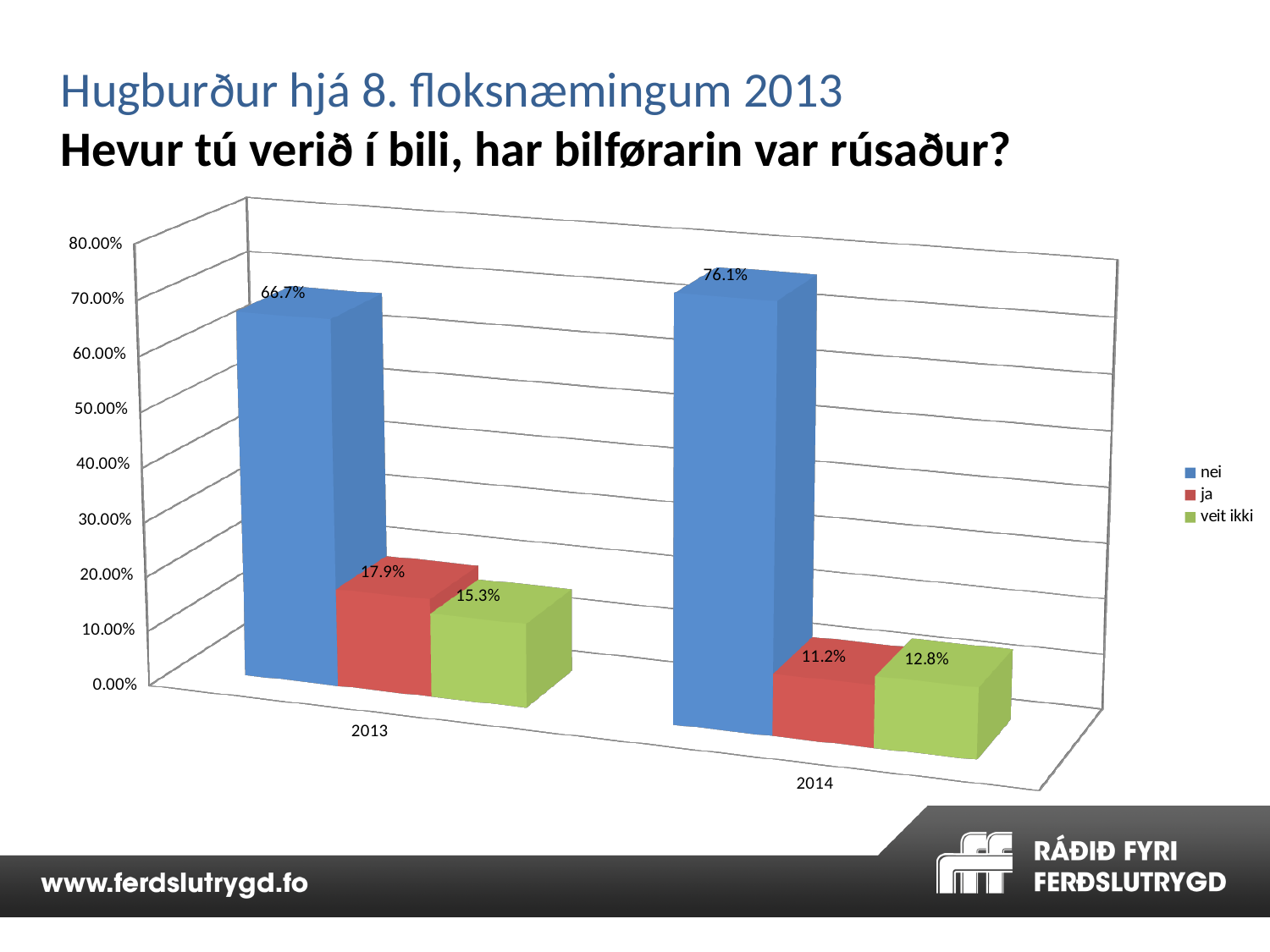
What is the value for "nei" in 2014? 76.1% Does the value for "nei" rise or fall from 2013 to 2014? Rise How many year categories are shown on the x axis? 2 Which series has the lowest value in 2013? veit ikki Which is larger: "ja" in 2013 or "ja" in 2014? ja in 2013 Which series has the highest value in 2014? nei What is the value for "veit ikki" in 2013? 15.3% What kind of chart is shown on the slide? Bar chart What is the difference between the "nei" values for 2014 and 2013? 9.4% What is the value for "ja" in 2014? 11.2% What is the value for "nei" in 2013? 66.7% How many series does the legend list? 3